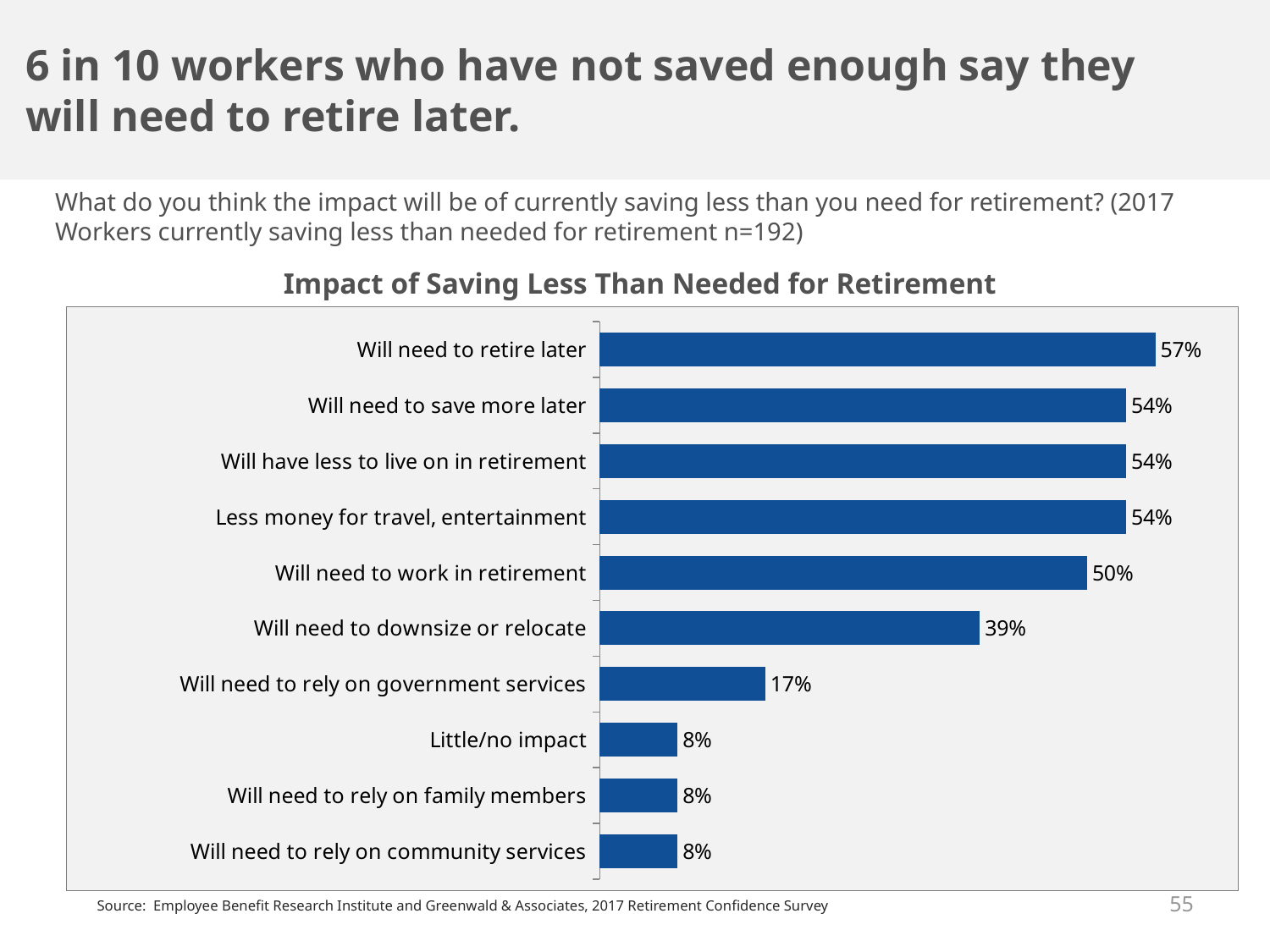
What percentage say they will need to rely on government services? 17% Which is larger: 'Will need to retire later' or 'Will need to save more later'? Will need to retire later How many categories are shown in the chart? 10 What percentage of workers say they will need to retire later? 57% What is the difference between 'Will need to downsize or relocate' and 'Will need to rely on government services'? 22% What is the value for 'Will need to downsize or relocate'? 39% What kind of chart is shown on the slide? Bar chart What is the title of the chart? Impact of Saving Less Than Needed for Retirement What is the value for 'Will need to work in retirement'? 50% Which is larger: 'Will need to downsize or relocate' or 'Will need to rely on government services'? Will need to downsize or relocate Which category has the highest value? Will need to retire later What is the difference between 'Will need to retire later' and 'Will need to work in retirement'? 7%